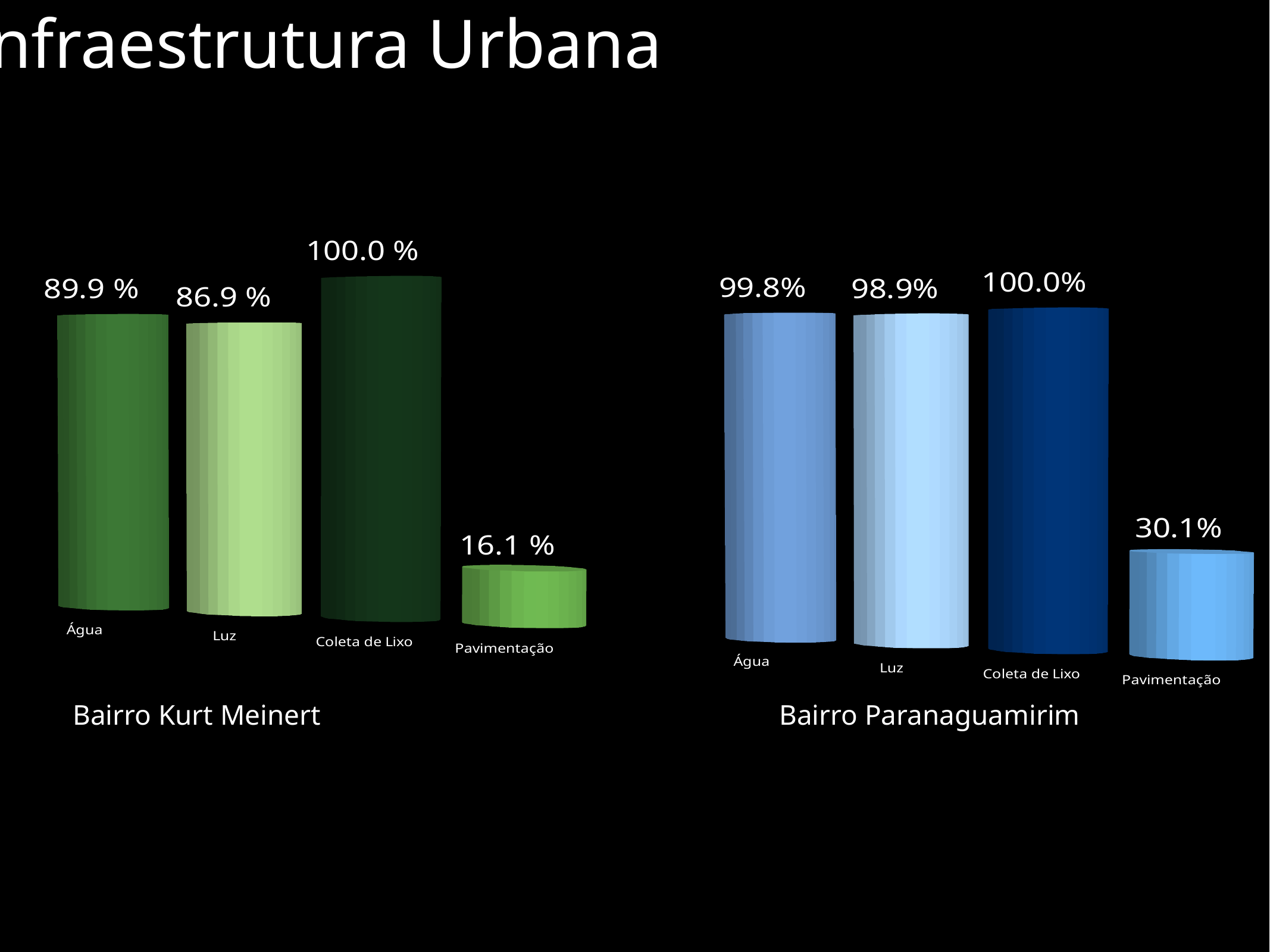
In the Bairro Paranaguamirim chart, what is the value for Pavimentação? 30.1% In the Bairro Kurt Meinert chart, what is the value for Água? 89.9 % In the Bairro Paranaguamirim chart, what is the difference between the values for Coleta de Lixo and Pavimentação? 69.9% In the Bairro Kurt Meinert chart, what is the value for Pavimentação? 16.1 % In the Bairro Paranaguamirim chart, which category has the lowest value? Pavimentação In the Bairro Kurt Meinert chart, what is the difference between the values for Água and Luz? 3.0 % What is the title of the chart on the right side of the slide? Bairro Paranaguamirim How many categories does the Bairro Kurt Meinert chart show? 4 What kind of chart is the Bairro Paranaguamirim chart? Bar chart Which is larger: the value for Pavimentação in the Bairro Kurt Meinert chart or in the Bairro Paranaguamirim chart? Bairro Paranaguamirim In the Bairro Kurt Meinert chart, which category has the highest value? Coleta de Lixo In the Bairro Paranaguamirim chart, what is the value for Luz? 98.9%